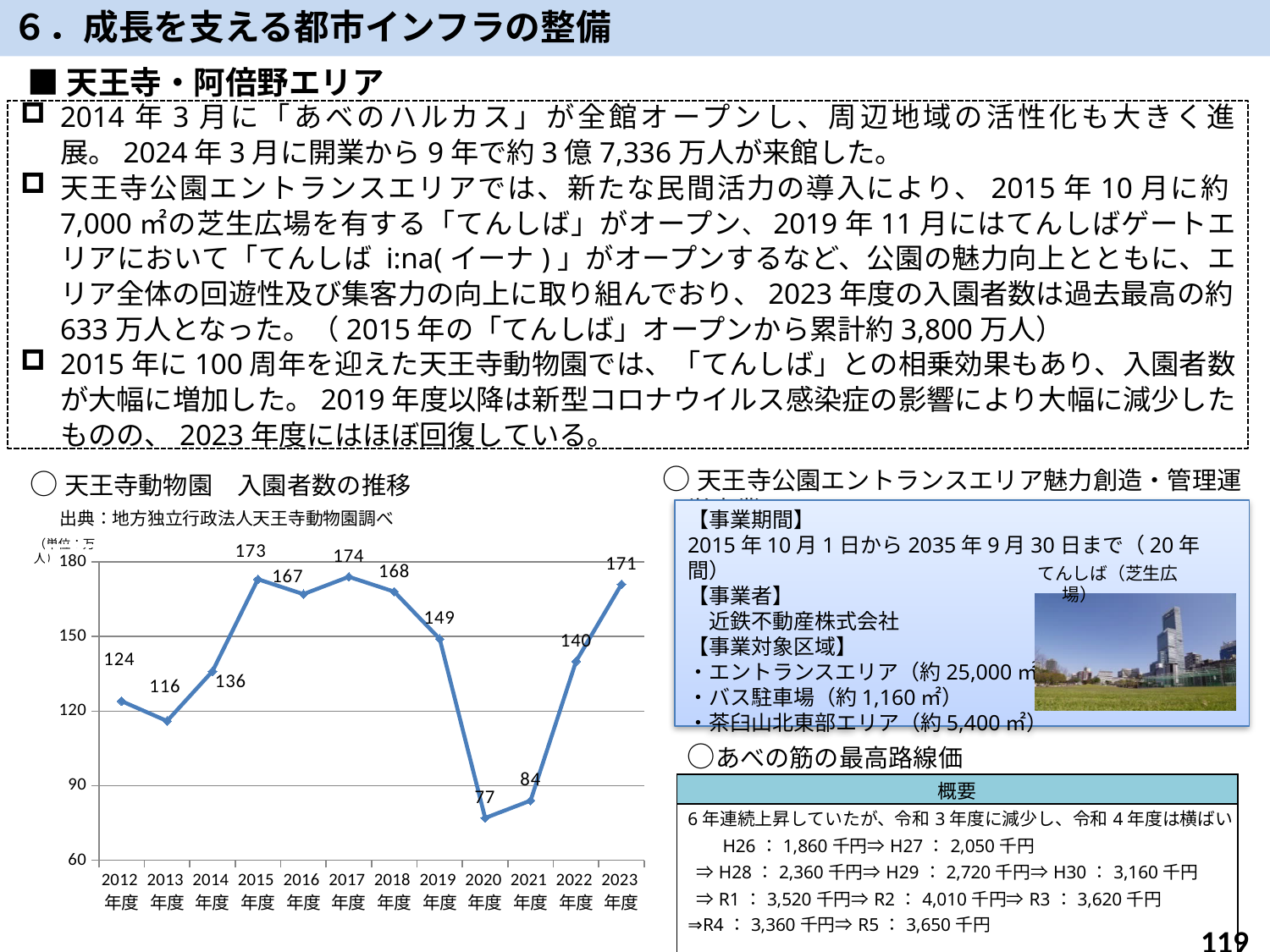
What type of chart is used to show 天王寺動物園 入園者数の推移? line chart In the 天王寺動物園 入園者数の推移 chart, what is the value for 2023年度? 171 How many fiscal years are plotted in the 天王寺動物園 入園者数の推移 chart? 12 In the 天王寺動物園 入園者数の推移 chart, which fiscal year has the lowest value? 2020年度 What is the source cited for the 天王寺動物園 入園者数の推移 chart? 地方独立行政法人天王寺動物園調べ In the 天王寺動物園 入園者数の推移 chart, do the values rise or fall from 2019年度 to 2020年度? fall In the 天王寺動物園 入園者数の推移 chart, is the value for 2021年度 greater or less than 90? less In the 天王寺動物園 入園者数の推移 chart, what is the difference between the values for 2019年度 and 2020年度? 72 In the 天王寺動物園 入園者数の推移 chart, what is the value for 2020年度? 77 In the 天王寺動物園 入園者数の推移 chart, which is larger, the value for 2015年度 or the value for 2016年度? 2015年度 In the 天王寺動物園 入園者数の推移 chart, which fiscal year has the highest value? 2017年度 In the 天王寺動物園 入園者数の推移 chart, what is the value for 2012年度? 124